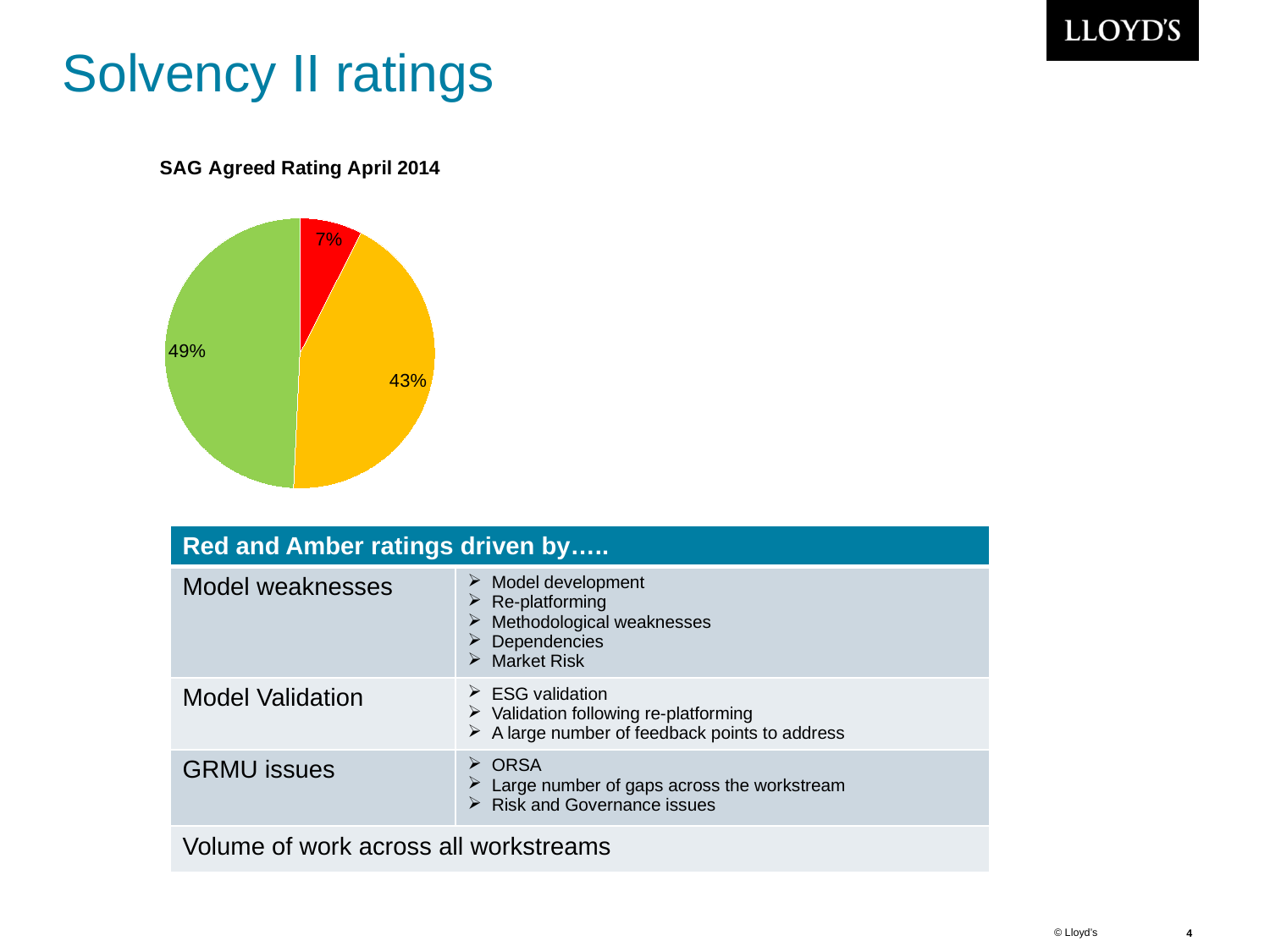
Which slice of the pie chart is the smallest? the red slice (7%) Which is larger, the green slice or the amber slice? the green slice What is the title of the pie chart? SAG Agreed Rating April 2014 How many slices does the pie chart have? 3 What share of the pie does the red slice represent? 7% What percentage is shown on the red slice of the pie chart? 7% Which slice of the pie chart is the largest? the green slice (49%) What is the difference in percentage points between the green slice and the amber slice? 6 What percentage is shown on the green slice of the pie chart? 49% What percentage is shown on the amber (yellow) slice of the pie chart? 43% What is the difference in percentage points between the amber slice and the red slice? 36 What kind of chart is shown on the slide? pie chart